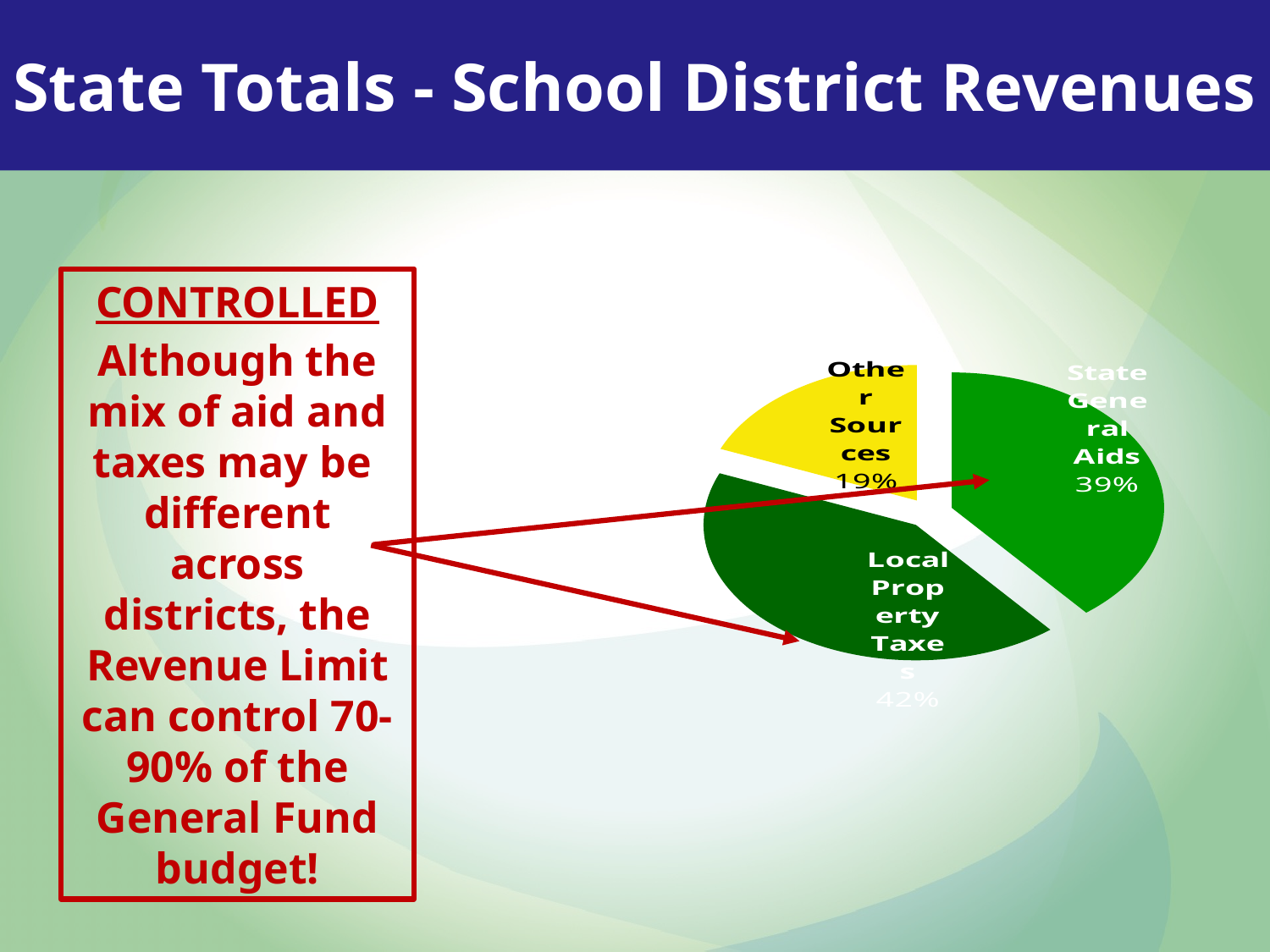
What share of the pie is State General Aids? 39% What is the title of the slide containing the pie chart? State Totals - School District Revenues Which slice of the pie chart is the largest? Local Property Taxes What is the difference in percentage points between Local Property Taxes and Other Sources? 23 Which slice of the pie chart is the smallest? Other Sources How many slices does the pie chart have? 3 What kind of chart is shown on the slide? pie chart What colour is the Other Sources slice of the pie chart? yellow Which is larger, the share for State General Aids or the share for Other Sources? State General Aids What is the difference in percentage points between State General Aids and Other Sources? 20 What share of the pie is Local Property Taxes? 42% What share of the pie is Other Sources? 19%